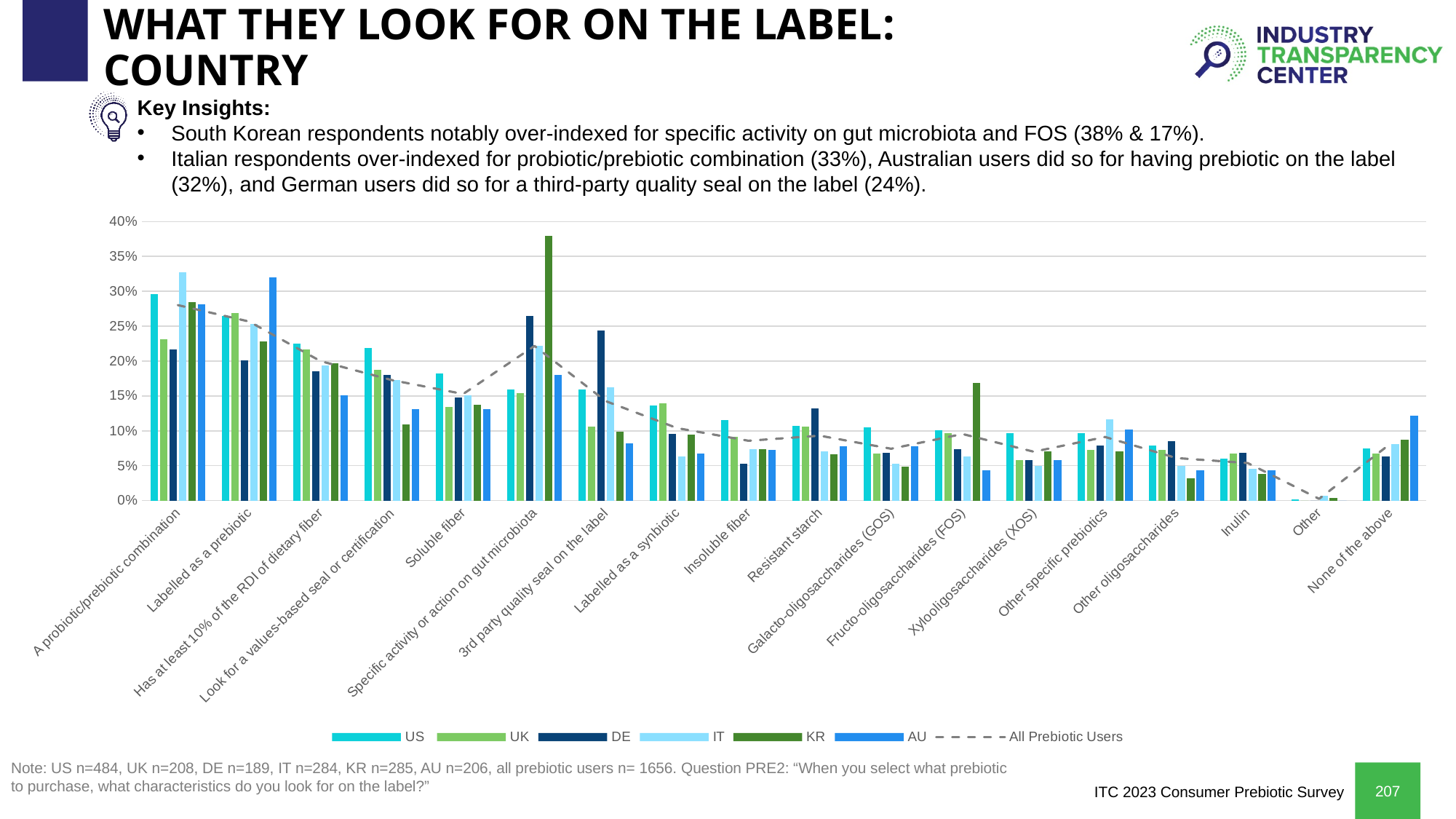
Which series is drawn as a dashed line rather than bars? All Prebiotic Users What kind of chart is shown on the slide? combination bar and line chart Is the DE value for '3rd party quality seal on the label' greater or less than 20%? greater Which is larger for 'Fructo-oligosaccharides (FOS)': the KR bar or the AU bar? KR Is the AU value for 'Labelled as a prebiotic' greater or less than 30%? greater Which country has the tallest bar for 'Specific activity or action on gut microbiota'? KR Is the US value for 'A probiotic/prebiotic combination' greater or less than 25%? greater How many label characteristics (categories) are shown along the x axis? 18 Which category has the lowest values across all countries? Other Does the dashed 'All Prebiotic Users' line generally rise or fall from 'A probiotic/prebiotic combination' to 'Other'? fall How many series does the legend list? 7